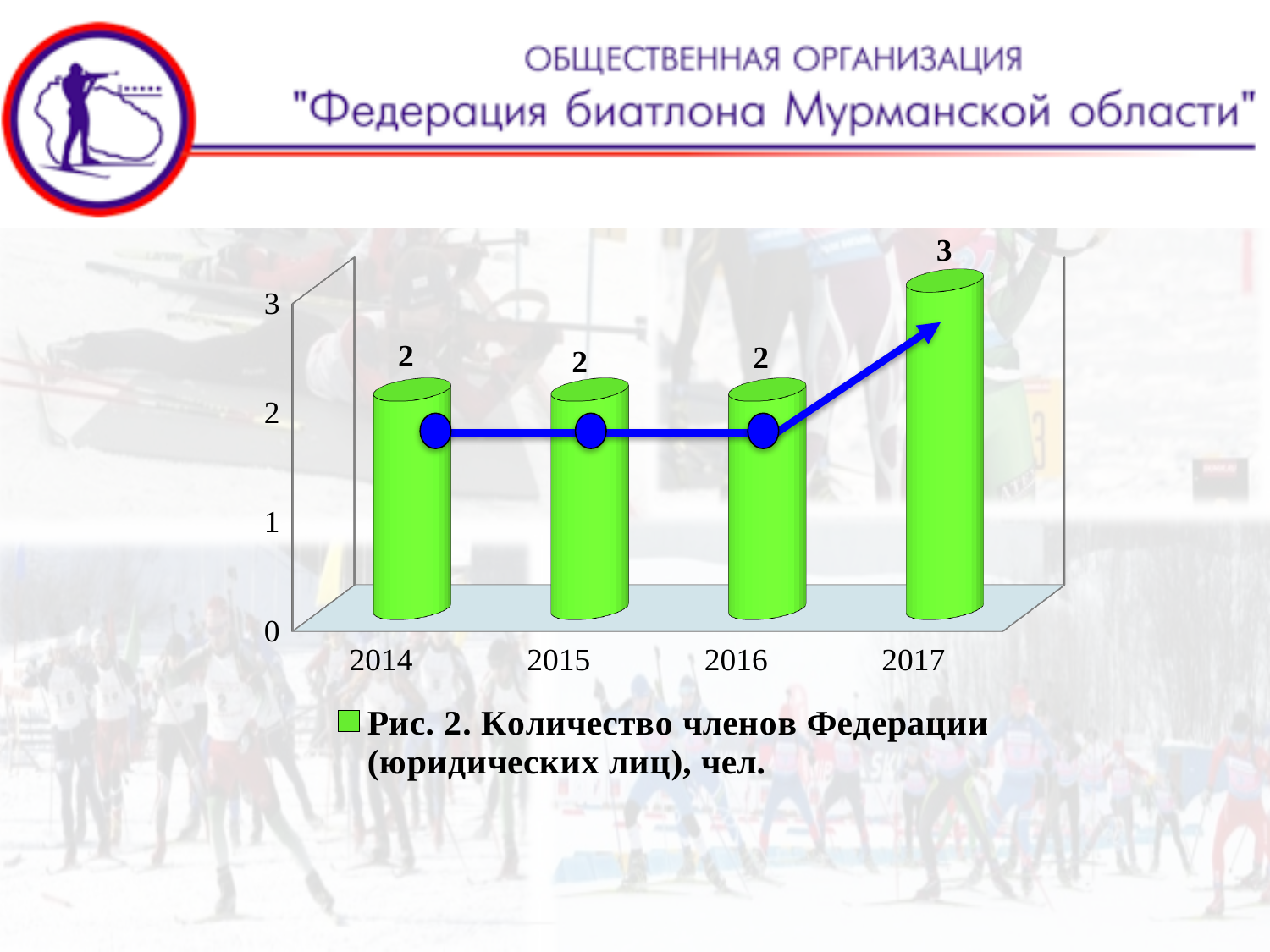
What is the legend entry for the series? Рис. 2. Количество членов Федерации (юридических лиц), чел. What is the value for 2017? 3 How many years are shown on the x axis? 4 What is the value for 2014? 2 What is the value for 2016? 2 Which is larger, the value for 2015 or the value for 2017? 2017 What colour are the bars? green Which year has the highest value? 2017 What is the difference between the values for 2017 and 2016? 1 Do the values rise or fall from 2016 to 2017? rise What kind of chart is this? bar chart How many series does the legend list? 1